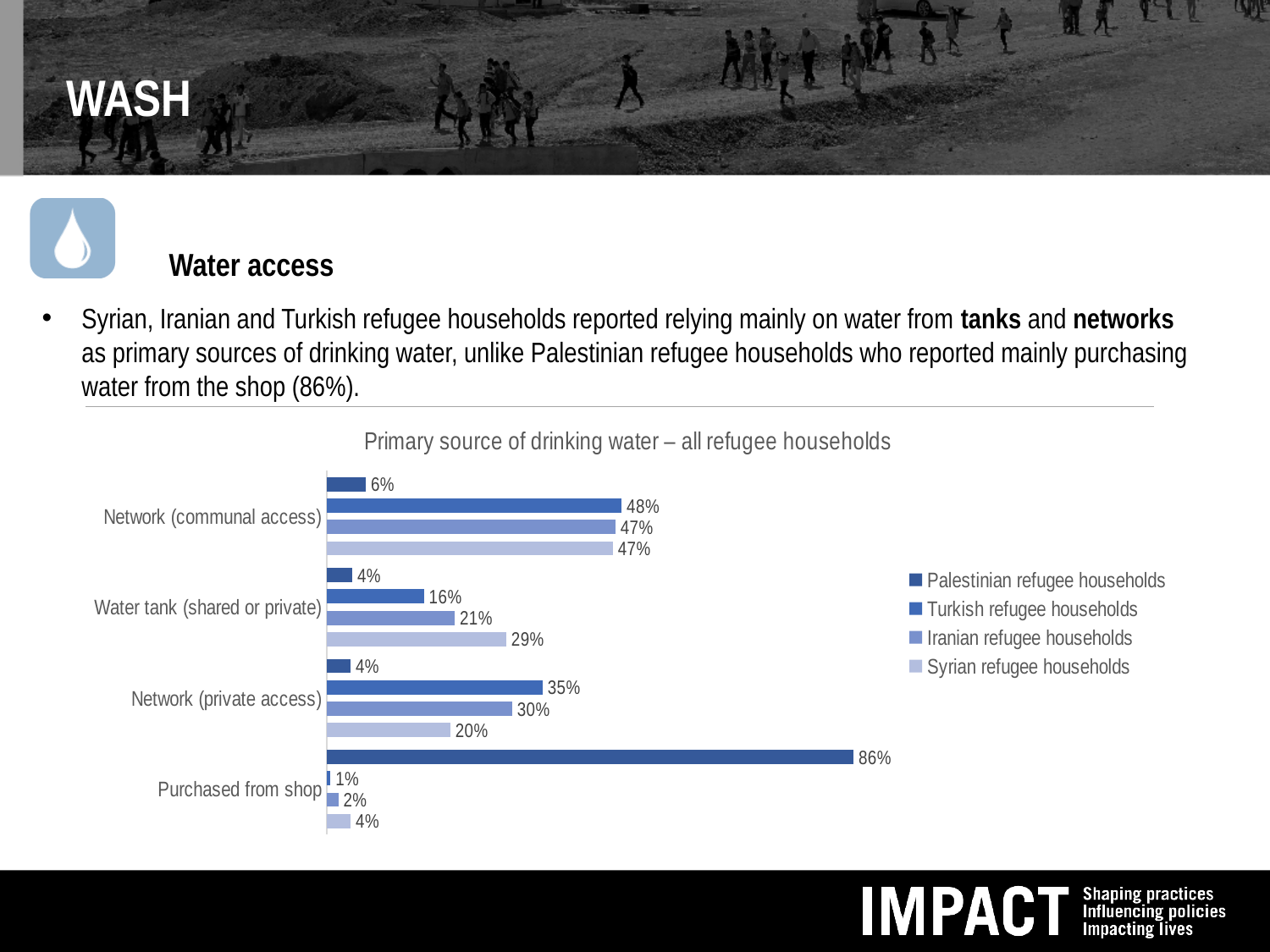
What percentage of Turkish refugee households reported network (private access) as their primary source? 35% For network (private access), which is larger: the value for Iranian refugee households or Syrian refugee households? Iranian refugee households What is the difference between the Syrian and Turkish refugee household values for water tank (shared or private)? 13% How many series does the legend list? 4 Which category has the lowest value for Turkish refugee households? Purchased from shop What percentage of Palestinian refugee households reported purchasing water from the shop? 86% How many water source categories are shown on the chart? 4 What is the title of the chart? Primary source of drinking water – all refugee households What is the value for Iranian refugee households for network (communal access)? 47% What percentage of Syrian refugee households reported a water tank (shared or private) as their primary source? 29% What kind of chart is shown on the slide? Bar chart Which category has the highest value for Palestinian refugee households? Purchased from shop